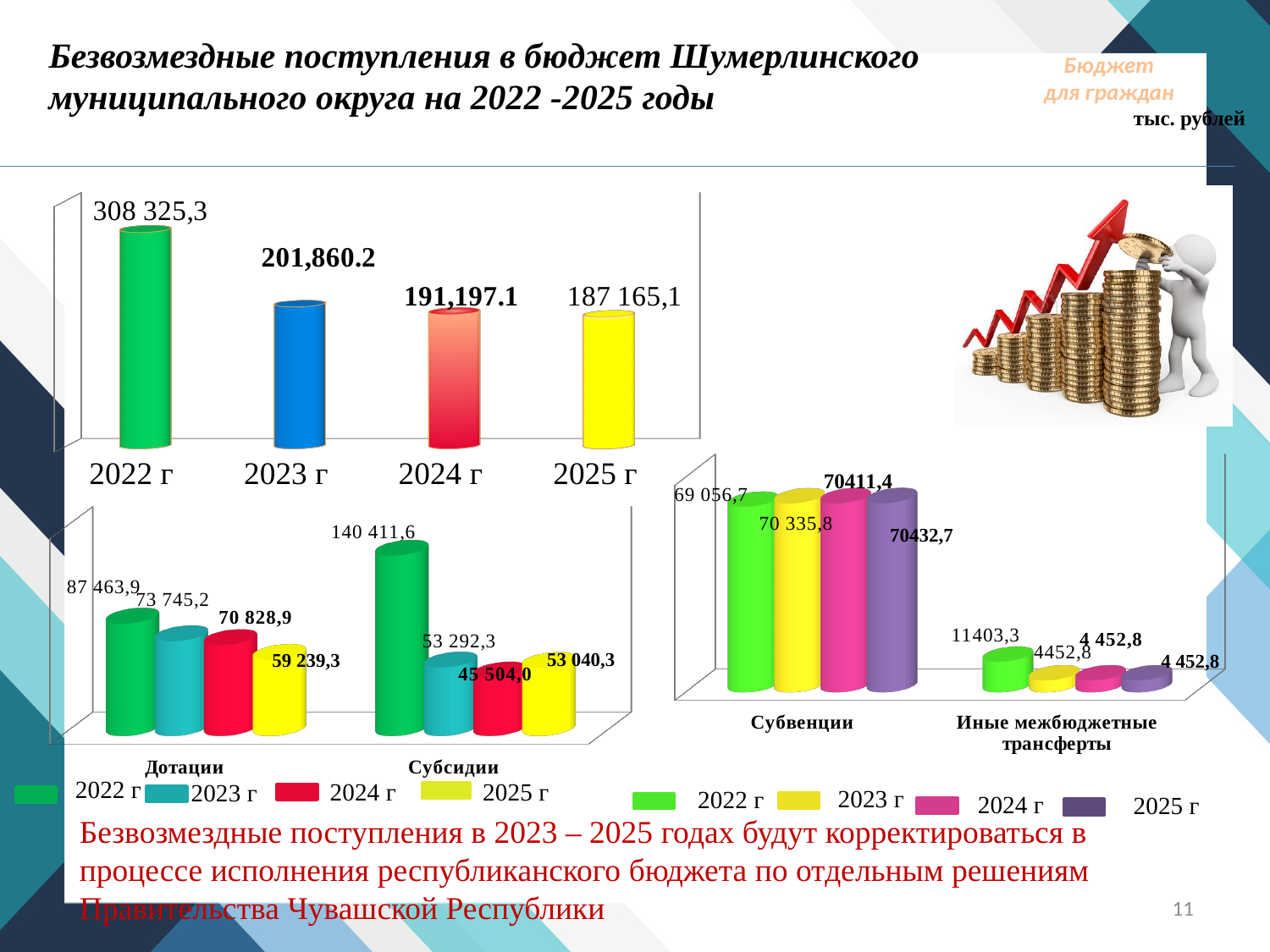
In the bottom-left chart, what is the value for Субсидии in 2022 г? 140 411,6 In the bottom-right chart, what is the value for Субвенции in 2023 г? 70 335,8 What kind of chart is the top-left chart? bar chart In the bottom-left chart, what is the value for Дотации in 2025 г? 59 239,3 In the bottom-left chart, which is larger in 2022 г: Дотации or Субсидии? Субсидии In the top-left chart, do the values rise or fall from 2022 г to 2025 г? fall In the bottom-right chart, what is the value for Иные межбюджетные трансферты in 2022 г? 11403,3 In the top-left chart, which year has the lowest value? 2025 г In the top-left chart, which year has the highest value? 2022 г In the top-left chart, what is the difference between the values for 2022 г and 2025 г? 121 160,2 In the bottom-left chart, how many series does the legend list? 4 In the top-left chart, what is the value for 2022 г? 308 325,3